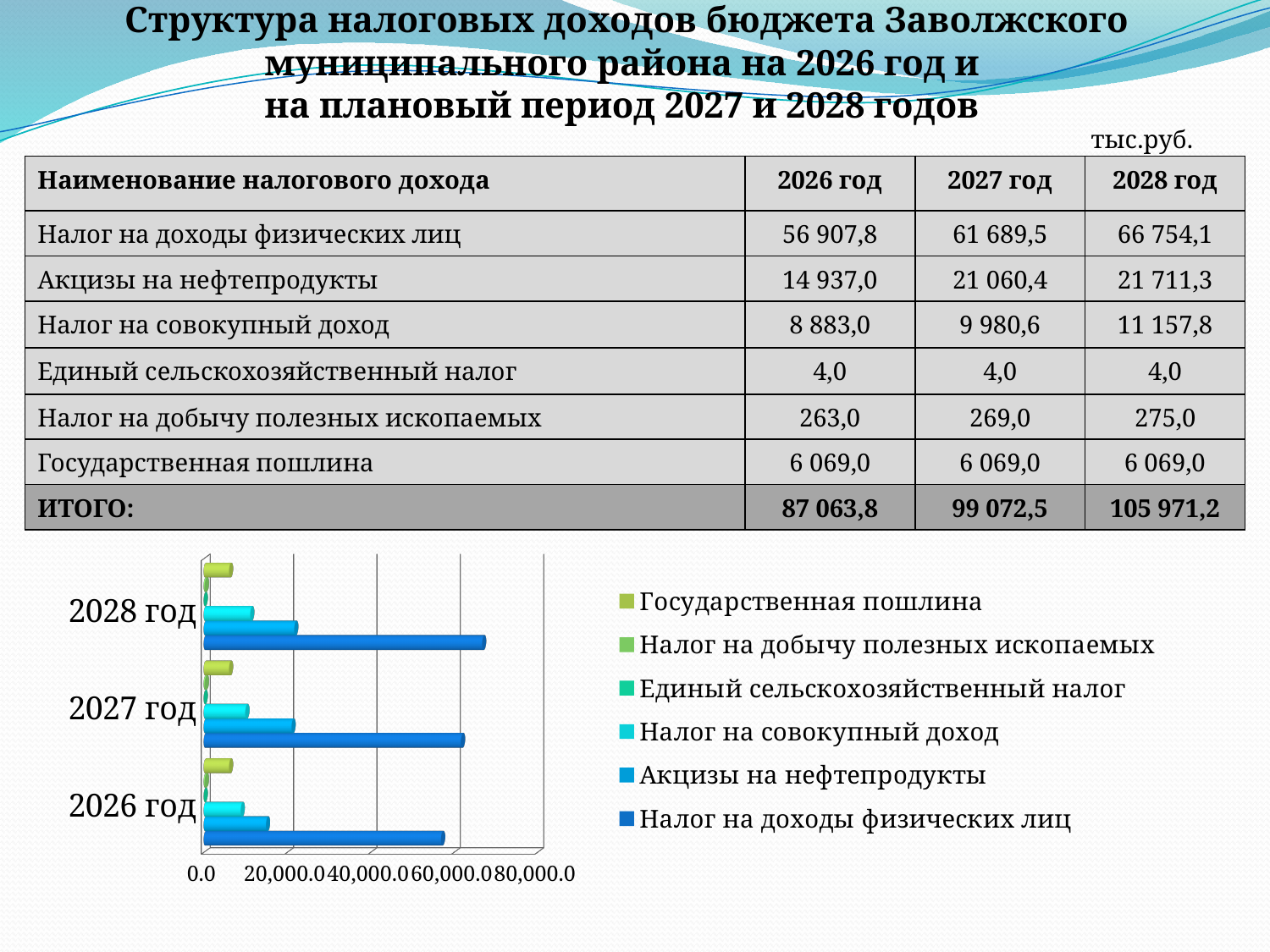
In which year is the bar for Налог на доходы физических лиц the longest? 2028 год How many series does the chart legend list? 6 In 2026 год, which is larger: Акцизы на нефтепродукты or Налог на совокупный доход? Акцизы на нефтепродукты What kind of chart is shown at the bottom of the slide? bar chart What is the value of Налог на доходы физических лиц for 2028 год? 66 754,1 Is the bar for Акцизы на нефтепродукты in 2026 год greater or less than 20,000.0? less By how much does Налог на доходы физических лиц in 2028 год exceed its value in 2026 год? 9 846,3 Is the bar for Налог на доходы физических лиц in 2026 год greater or less than 60,000.0? less Do the bars for Налог на доходы физических лиц rise or fall from 2026 год to 2028 год? rise How many year categories does the bar chart show? 3 What is the value of Государственная пошлина for 2027 год? 6 069,0 Which series is shown in dark blue in the chart legend? Налог на доходы физических лиц